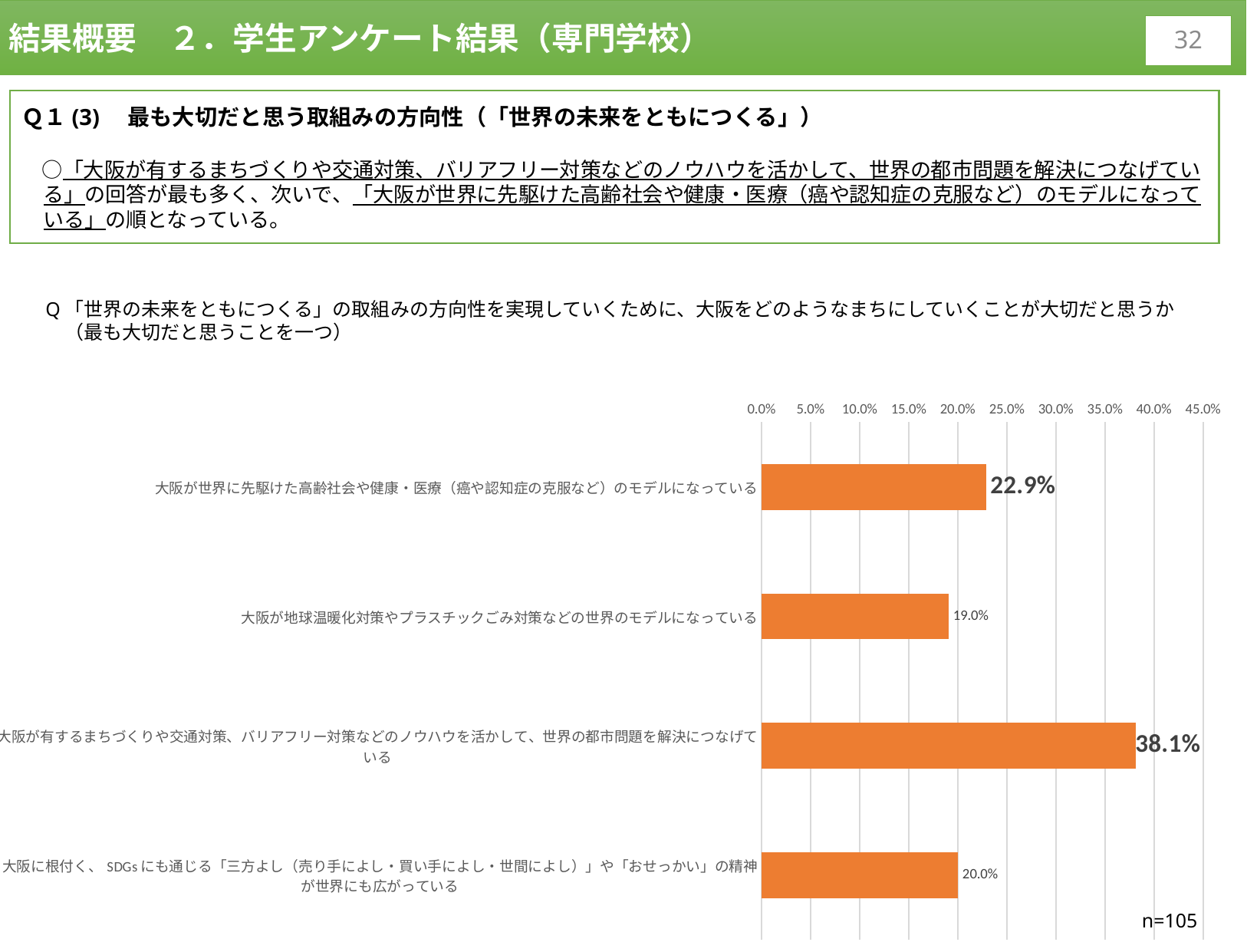
Which is larger: the value for 「大阪が地球温暖化対策やプラスチックごみ対策などの世界のモデルになっている」 or the value for 「大阪に根付く、SDGsにも通じる「三方よし」や「おせっかい」の精神が世界にも広がっている」? 大阪に根付く、SDGsにも通じる「三方よし」や「おせっかい」の精神が世界にも広がっている What is the value for 「大阪が地球温暖化対策やプラスチックごみ対策などの世界のモデルになっている」? 19.0% Which category has the highest value? 大阪が有するまちづくりや交通対策、バリアフリー対策などのノウハウを活かして、世界の都市問題を解決につなげている What is the value for 「大阪が世界に先駆けた高齢社会や健康・医療（癌や認知症の克服など）のモデルになっている」? 22.9% What is the sample size (n) shown on the chart? n=105 Is the value for 「大阪が有するまちづくりや交通対策、バリアフリー対策などのノウハウを活かして、世界の都市問題を解決につなげている」 greater or less than 35.0%? greater What is the value for 「大阪が有するまちづくりや交通対策、バリアフリー対策などのノウハウを活かして、世界の都市問題を解決につなげている」? 38.1% How many categories are shown in the chart? 4 What kind of chart is shown on the slide? Bar chart What is the value for 「大阪に根付く、SDGsにも通じる「三方よし」や「おせっかい」の精神が世界にも広がっている」? 20.0% What is the difference between the highest value (38.1%) and the value for 「大阪が世界に先駆けた高齢社会や健康・医療のモデルになっている」 (22.9%)? 15.2% Which category has the lowest value? 大阪が地球温暖化対策やプラスチックごみ対策などの世界のモデルになっている